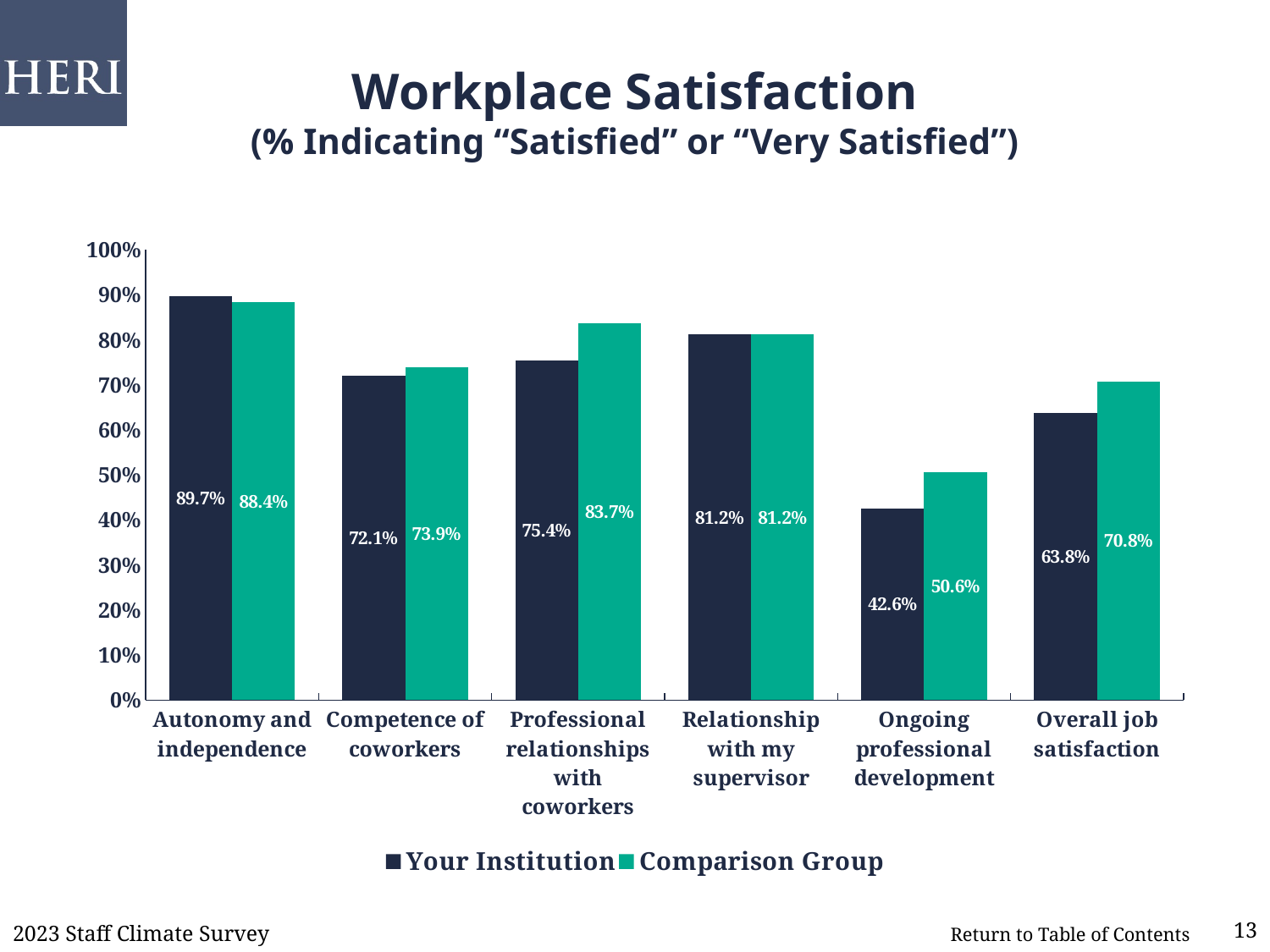
How many series does the legend list? 2 What is the subtitle of the chart? (% Indicating "Satisfied" or "Very Satisfied") How many categories are shown on the x axis? 6 What is the value for Comparison Group for Ongoing professional development? 50.6% What is the difference between the Comparison Group and Your Institution values for Professional relationships with coworkers? 8.3% Which category has the lowest value for Comparison Group? Ongoing professional development What is the value for Your Institution for Autonomy and independence? 89.7% What is the value for Your Institution for Overall job satisfaction? 63.8% Which category has the highest value for Your Institution? Autonomy and independence What kind of chart is shown on the slide? Bar chart Is the value for Your Institution for Ongoing professional development greater or less than 50%? less Which is larger for Overall job satisfaction: Your Institution or Comparison Group? Comparison Group